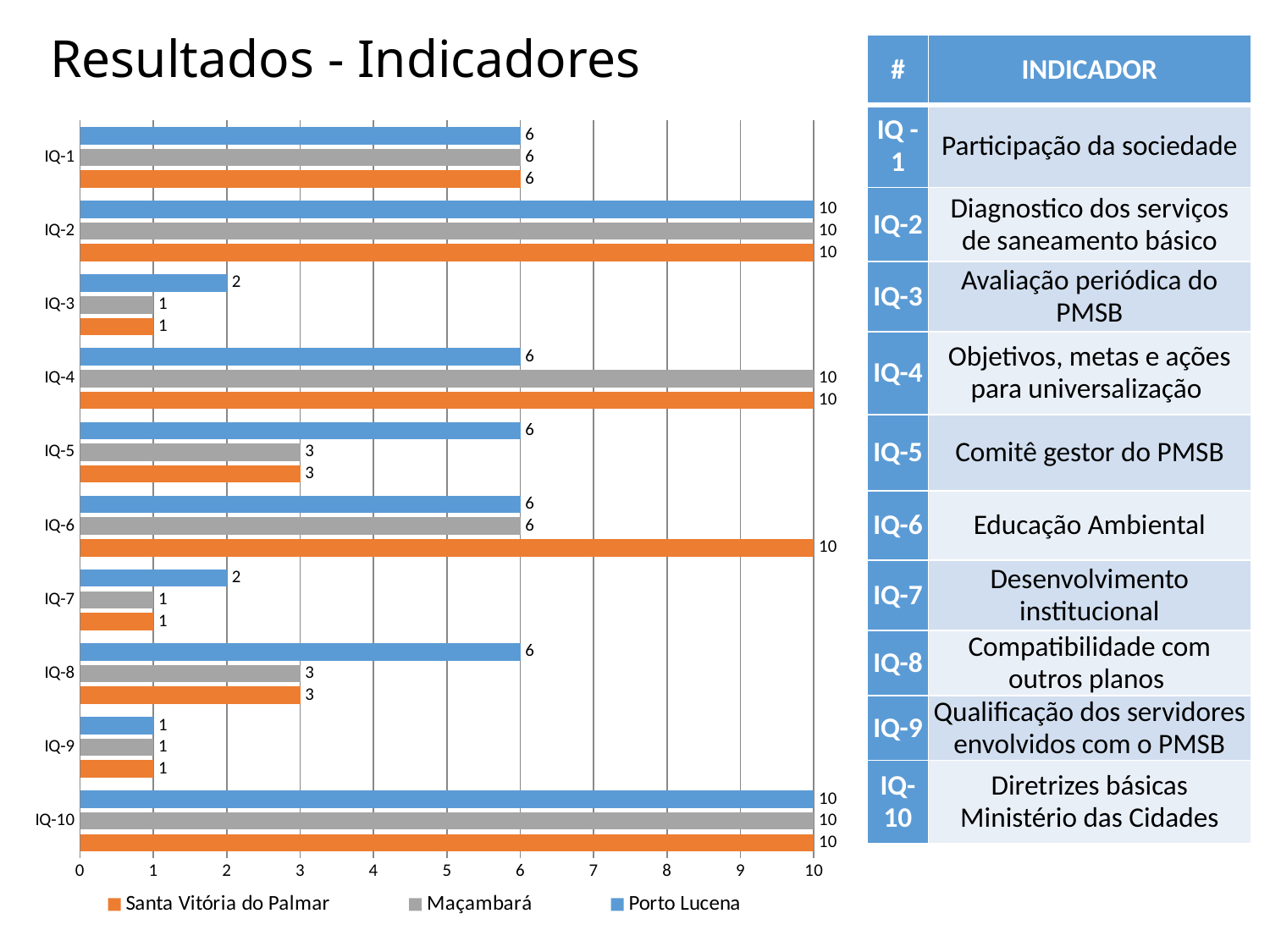
At IQ-8, which is larger: the value for Porto Lucena or the value for Maçambará? Porto Lucena Which colour represents Maçambará in the chart? gray What is the value for Porto Lucena at IQ-3? 2 What is the difference between the Santa Vitória do Palmar value and the Porto Lucena value at IQ-6? 4 What is the value for Porto Lucena at IQ-4? 6 Which series has the lowest value at IQ-4? Porto Lucena What is the value for Santa Vitória do Palmar at IQ-6? 10 What kind of chart is shown on the slide? bar chart What is the value for Maçambará at IQ-5? 3 How many indicator categories (IQ-1 to IQ-10) are plotted on the chart? 10 What is the difference between the Porto Lucena value and the Maçambará value at IQ-7? 1 How many series does the chart legend list? 3